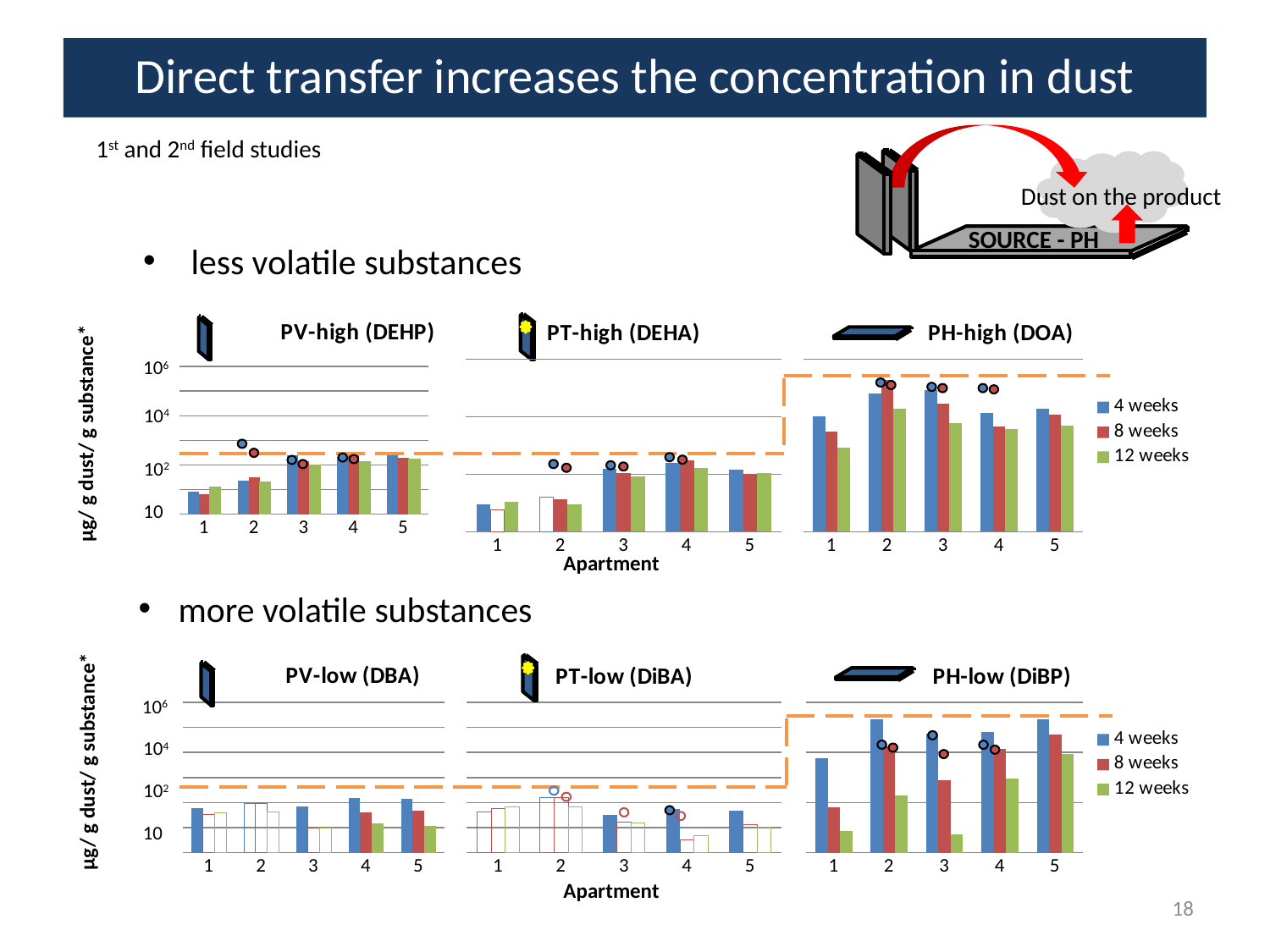
In the PH-low (DiBP) chart, is the 12 weeks value for apartment 1 greater or less than 10^2? less In the PH-low (DiBP) chart, which is larger for apartment 3: the 4 weeks value or the 12 weeks value? 4 weeks How many apartments are shown on the x axis of the PV-high (DEHP) chart? 5 How many series does the legend next to the PH-high (DOA) chart list? 3 What kind of chart is the PH-high (DOA) chart? bar chart What is the x-axis label under the PT-high (DEHA) chart? Apartment In the PH-high (DOA) chart, which is larger for apartment 1: the 4 weeks value or the 12 weeks value? 4 weeks In the PV-high (DEHP) chart, do the 4 weeks values rise or fall from apartment 1 to apartment 5? rise In the PH-high (DOA) chart, is the 4 weeks value for apartment 2 greater or less than 10^4? greater In the PH-low (DiBP) chart, which apartment has the lowest 8 weeks value? 1 In the PV-high (DEHP) chart, is the 4 weeks value for apartment 1 greater or less than 10^2? less What are the legend entries for the PH-low (DiBP) chart? 4 weeks, 8 weeks, 12 weeks